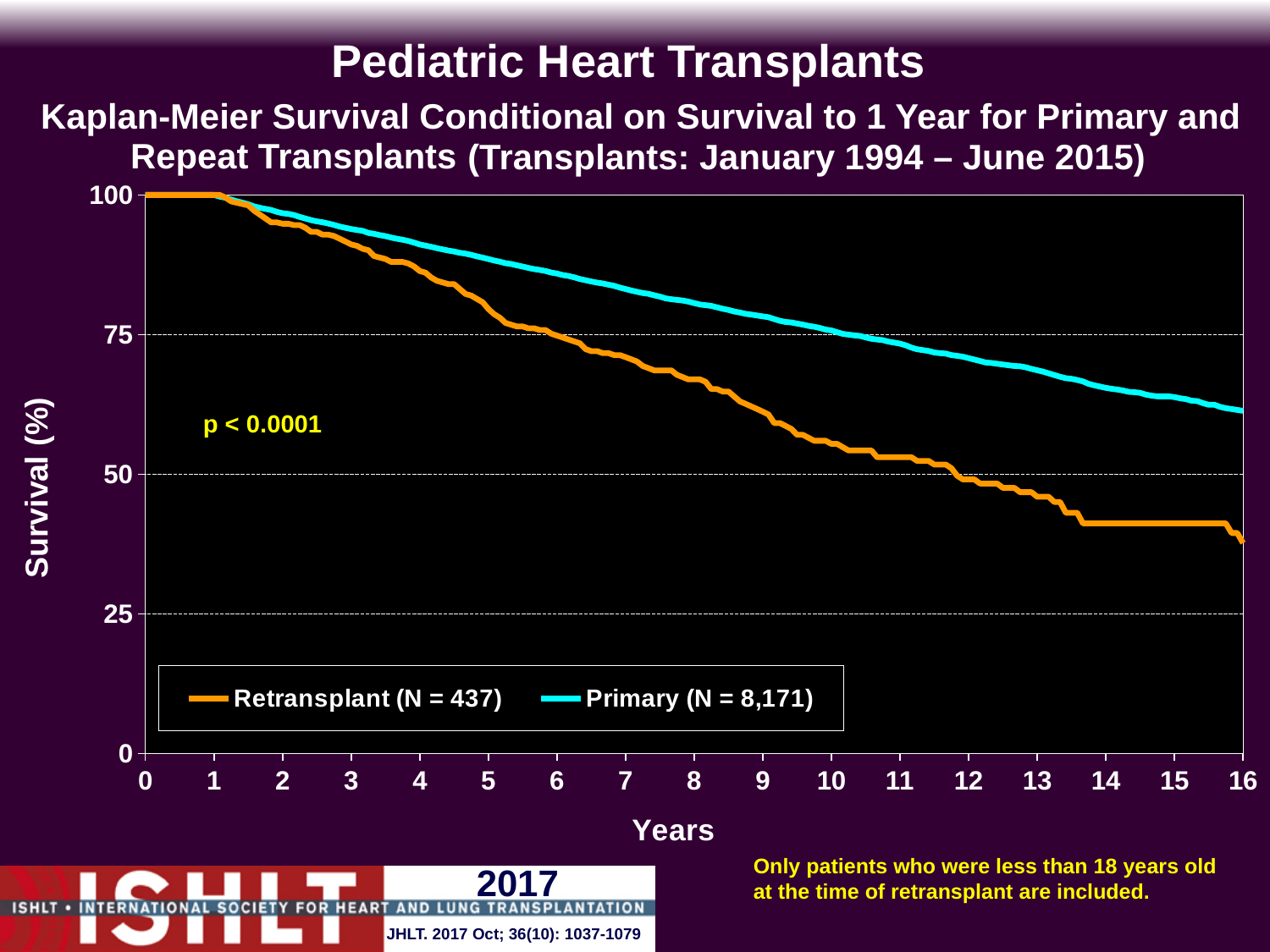
Which series has the higher survival at 16 years, Retransplant or Primary? Primary Is the survival for Retransplant at 16 years greater or less than 50? less What is the sample size (N) for the Retransplant group? 437 What is the sample size (N) for the Primary group? 8,171 Is the survival for Retransplant at 8 years greater or less than 75? less Is the survival for Primary at 8 years greater or less than 75? greater What is the maximum value shown on the x axis (Years)? 16 Do the survival curves rise or fall as years increase? fall What kind of chart is shown on the slide? line chart How many series does the legend list? 2